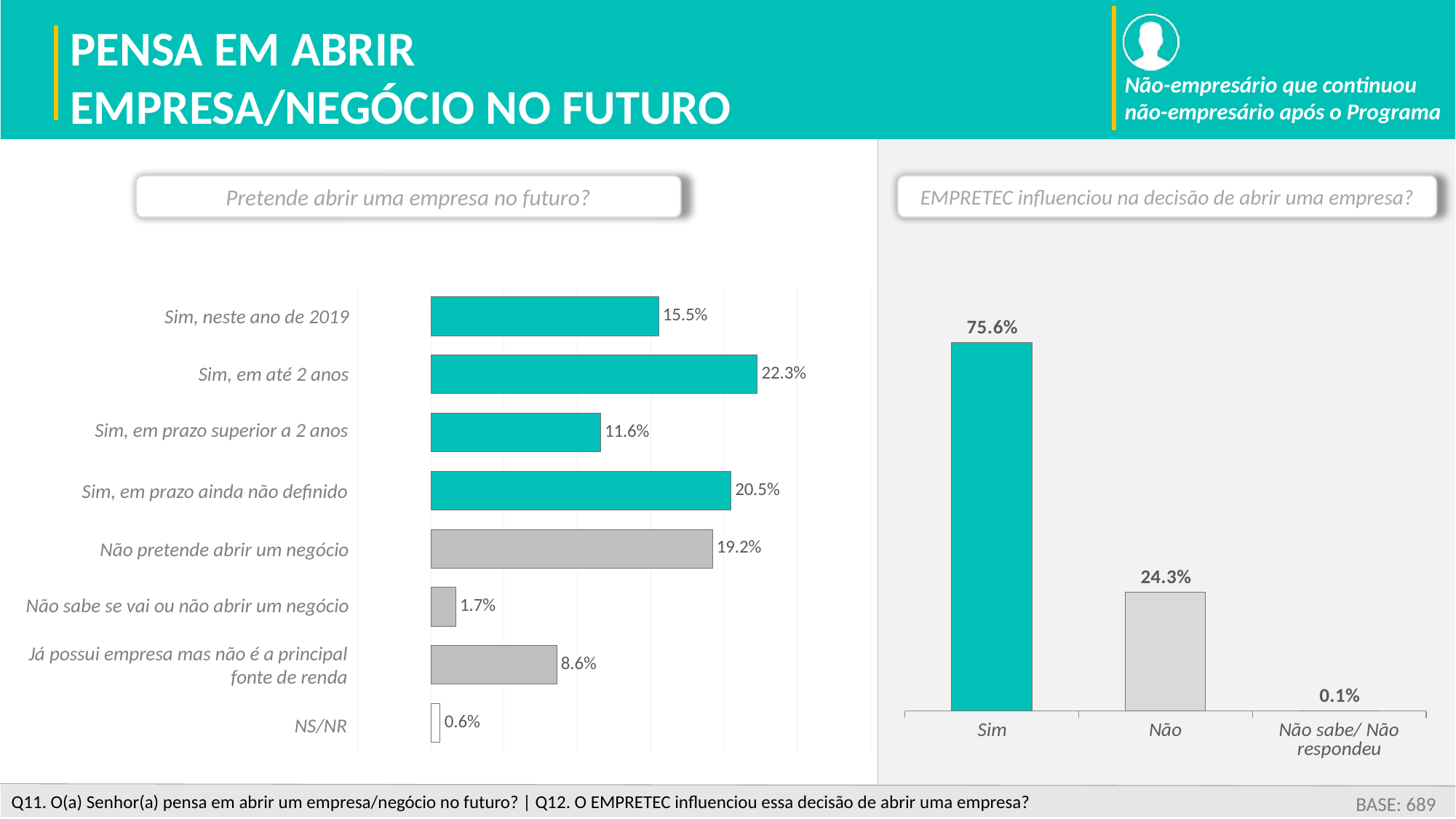
In the left chart 'Pretende abrir uma empresa no futuro?', what is the difference between 'Sim, em até 2 anos' and 'Sim, em prazo superior a 2 anos'? 10.7% How many categories are shown in the right chart 'EMPRETEC influenciou na decisão de abrir uma empresa?'? 3 How many categories are shown in the left chart 'Pretende abrir uma empresa no futuro?'? 8 In the right chart 'EMPRETEC influenciou na decisão de abrir uma empresa?', what is the difference between 'Sim' and 'Não'? 51.3% In the right chart 'EMPRETEC influenciou na decisão de abrir uma empresa?', which category has the highest value? Sim What kind of chart is the left chart 'Pretende abrir uma empresa no futuro?'? Bar chart In the left chart 'Pretende abrir uma empresa no futuro?', which category has the lowest value? NS/NR In the left chart 'Pretende abrir uma empresa no futuro?', which category has the highest value? Sim, em até 2 anos In the left chart 'Pretende abrir uma empresa no futuro?', what is the value for 'Sim, em até 2 anos'? 22.3% In the right chart 'EMPRETEC influenciou na decisão de abrir uma empresa?', what is the value for 'Não'? 24.3% In the left chart 'Pretende abrir uma empresa no futuro?', what is the value for 'Não pretende abrir um negócio'? 19.2% In the left chart 'Pretende abrir uma empresa no futuro?', which is larger: 'Sim, neste ano de 2019' or 'Sim, em prazo ainda não definido'? Sim, em prazo ainda não definido